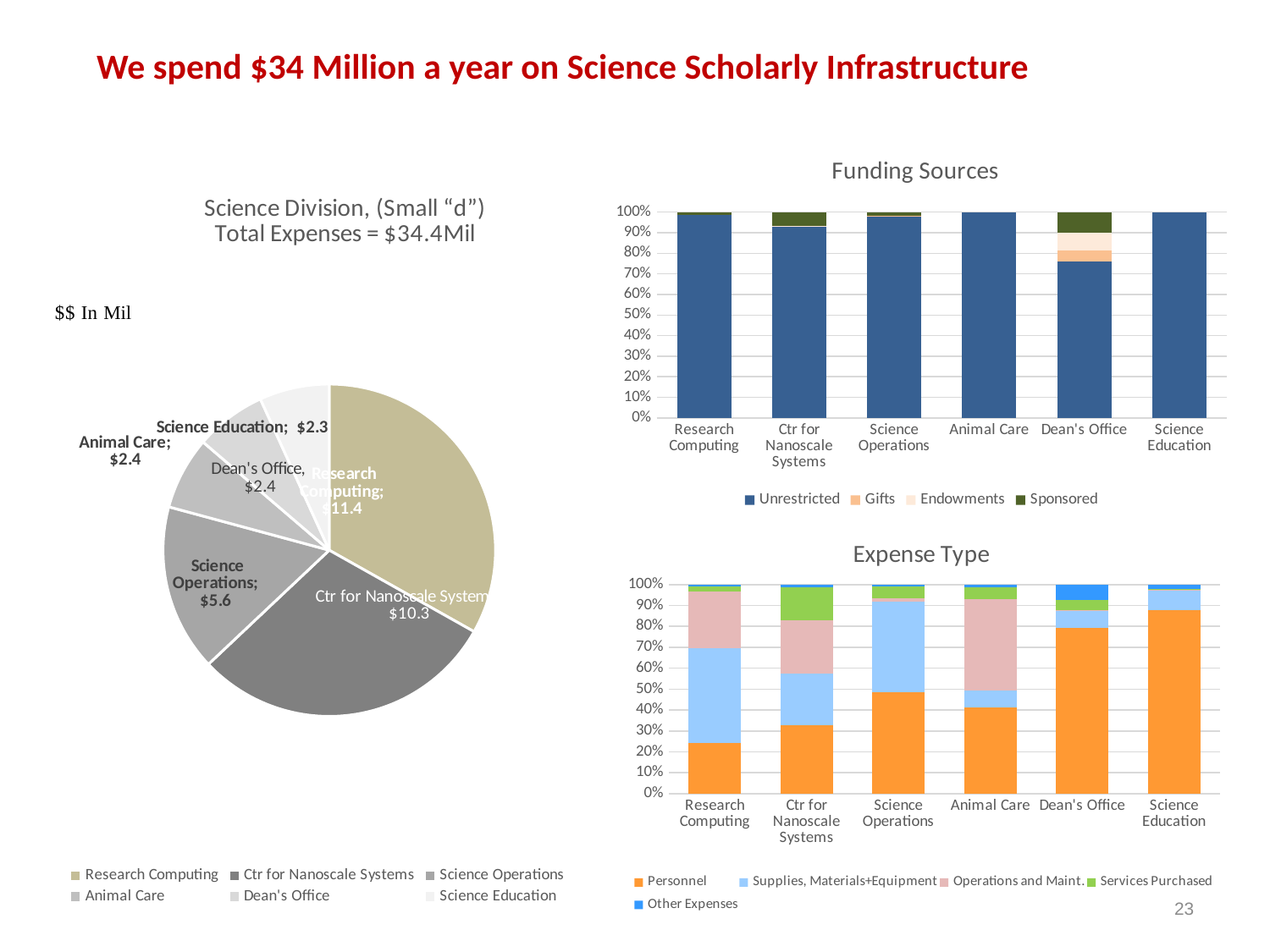
How many categories does the pie chart on the left show? 6 In the Expense Type chart, how many series does the legend list? 5 In the Funding Sources chart, how many series does the legend list? 4 In the pie chart on the left, what is the value for Science Operations? $5.6 What kind of chart is the Expense Type chart? Stacked bar chart In the pie chart on the left, what is the value for Research Computing? $11.4 In the Funding Sources chart, is the Unrestricted share for Dean's Office greater or less than 80%? less In the pie chart on the left, which category has the largest slice? Research Computing In the Expense Type chart, is the Personnel share for Research Computing greater or less than 30%? less In the pie chart on the left, which category has the smallest slice? Science Education In the pie chart on the left, what is the difference between Research Computing and Ctr for Nanoscale Systems? $1.1 In the pie chart on the left, which is larger, Science Operations or Animal Care? Science Operations